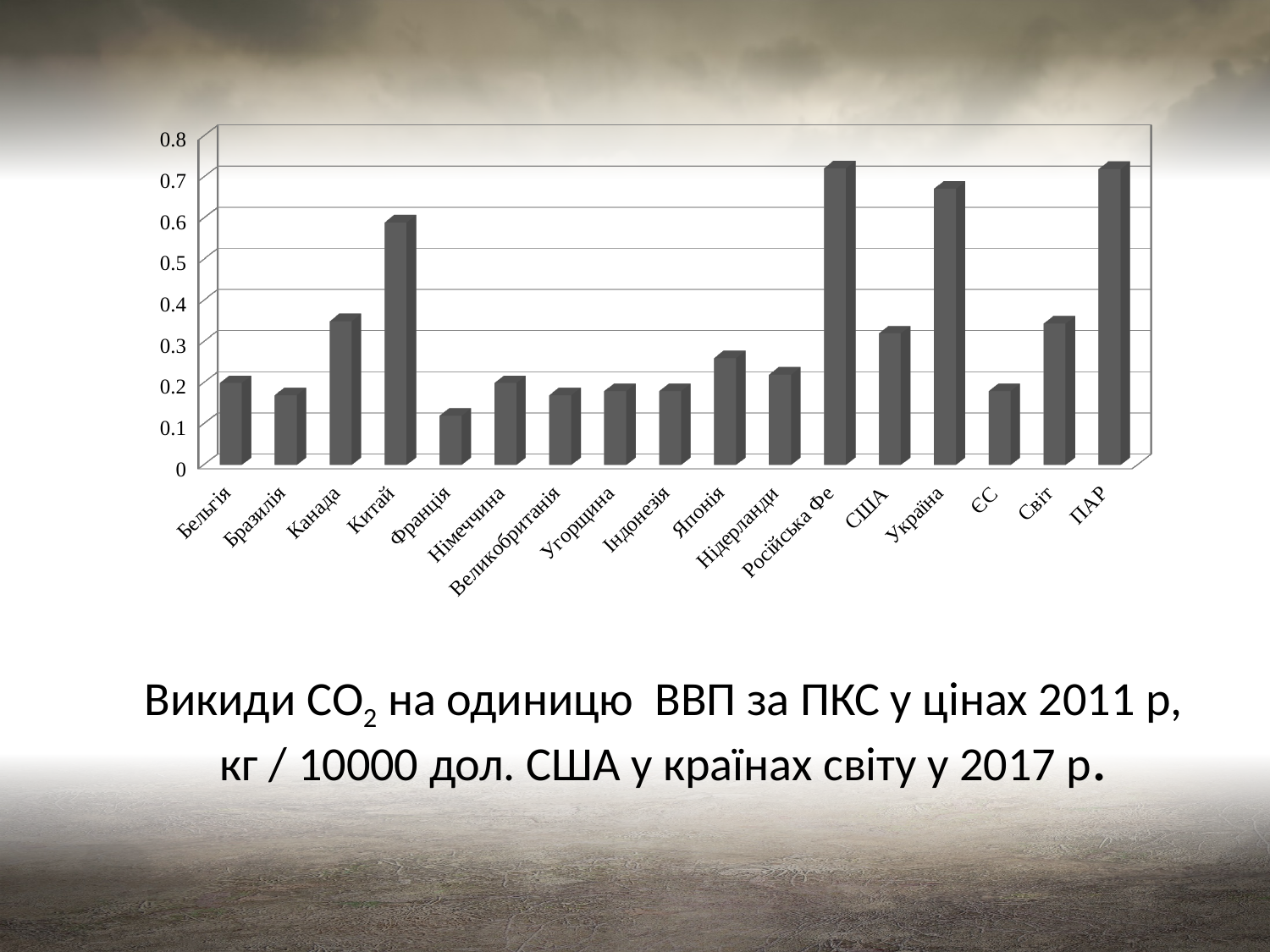
Is the value for Російська Фе greater or less than 0.6? greater Is the value for Україна greater or less than 0.6? greater Which has the larger value, Китай or Канада? Китай What is the highest value shown on the vertical axis of the chart? 0.8 Is the value for Франція greater or less than 0.2? less What kind of chart is shown on the slide? bar chart Which has the larger value, Україна or США? Україна How many countries or regions are shown on the x axis of the chart? 17 Which category has the lowest bar in the chart? Франція